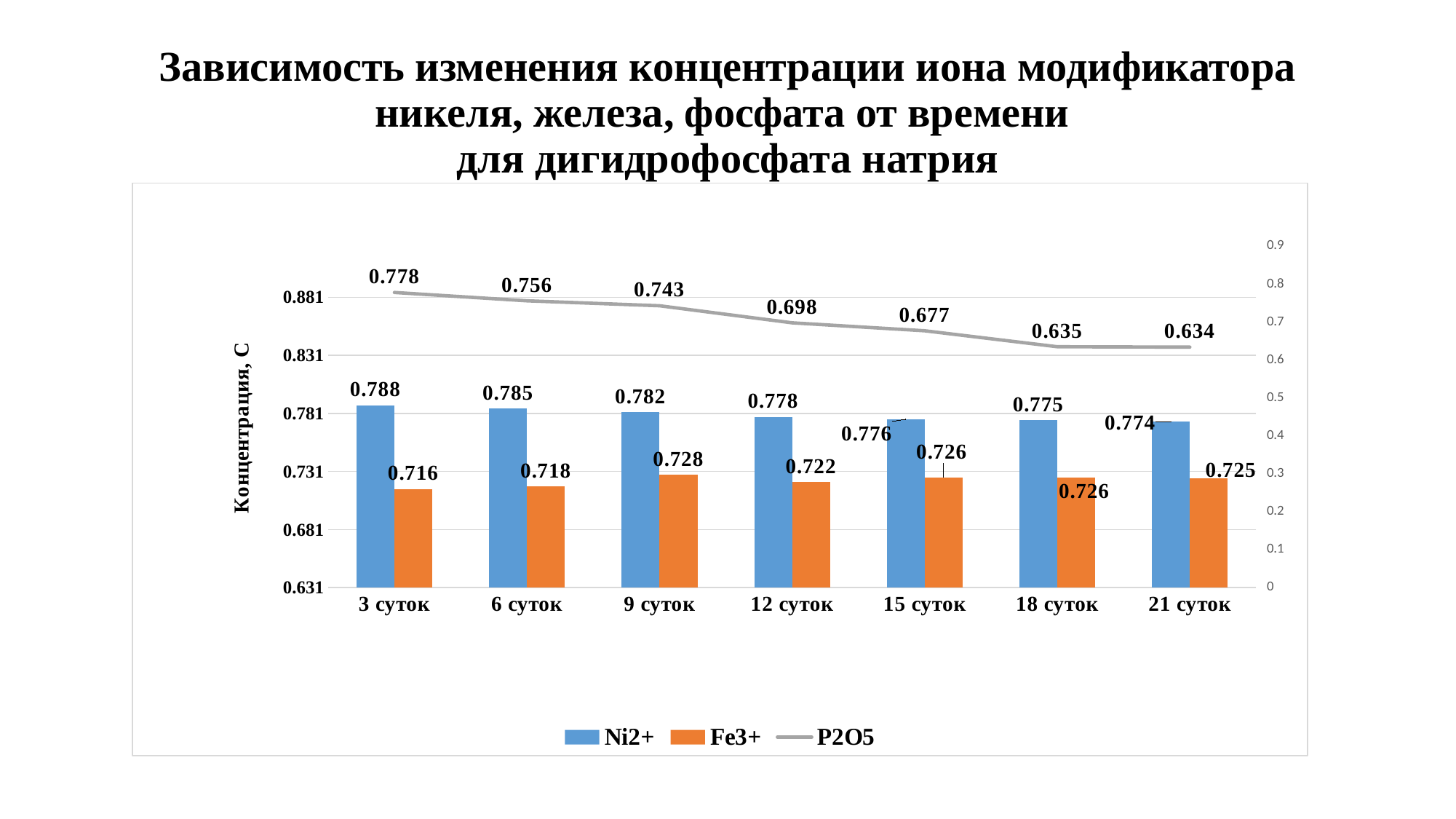
What is the value of Ni2+ at 3 суток? 0.788 How many series does the legend list? 3 What is the value of Fe3+ at 9 суток? 0.728 At which time point is the Ni2+ value highest? 3 суток Does the P2O5 line rise or fall from 3 суток to 21 суток? fall What is the value of P2O5 at 12 суток? 0.698 At which time point is the Fe3+ value lowest? 3 суток What is the value of Ni2+ at 21 суток? 0.774 Which is larger at 18 суток: the Ni2+ value or the Fe3+ value? Ni2+ How many time points are shown on the x axis? 7 At which time point is the Fe3+ value highest? 9 суток What is the difference between the Ni2+ and Fe3+ values at 3 суток? 0.072